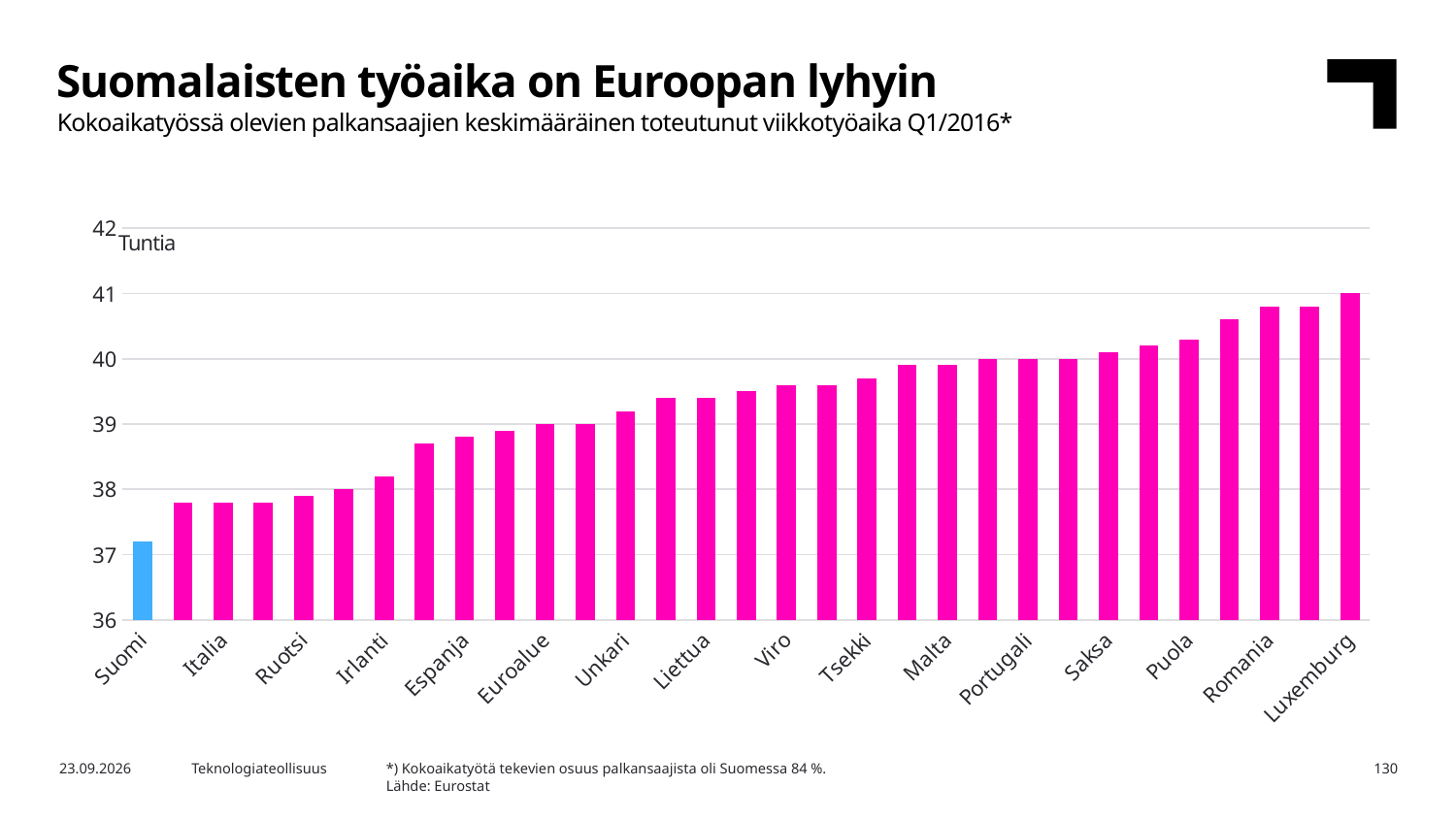
What is the title of the chart on the slide? Suomalaisten työaika on Euroopan lyhyin Is the value for Espanja greater or less than 39? less Is the value for Luxemburg greater or less than 40? greater What unit is shown at the top of the vertical axis? Tuntia Which country has the lowest average weekly working time in the chart? Suomi Is the value for Romania greater or less than 40? greater Which has a higher value, Italia or Romania? Romania What kind of chart is shown on the slide? bar chart Which country has the highest average weekly working time in the chart? Luxemburg Do the values rise or fall moving from left to right along the x axis? rise